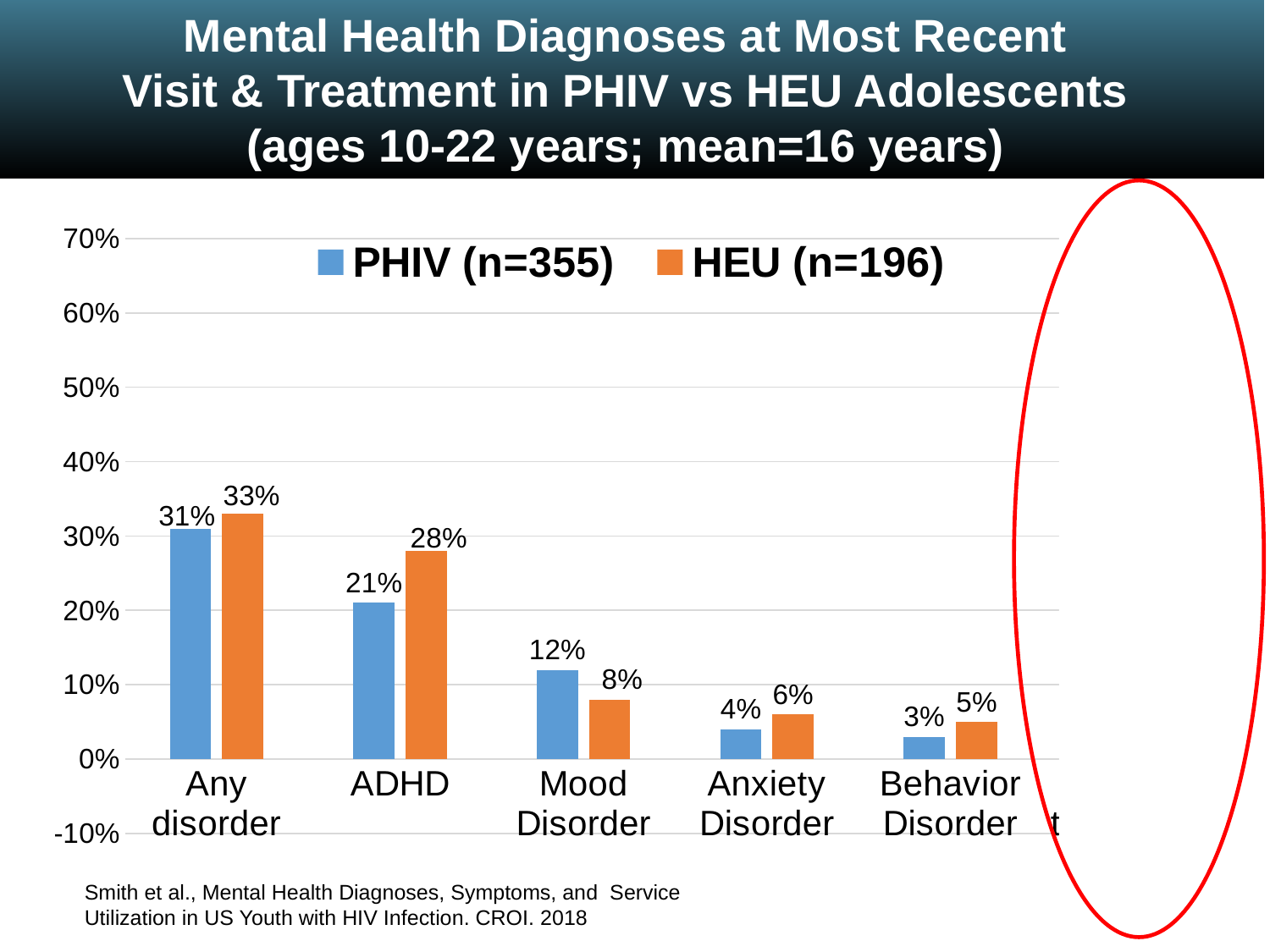
What is the HEU (n=196) value for Behavior Disorder? 5% What colour are the HEU (n=196) bars? orange What is the HEU (n=196) value for ADHD? 28% For Mood Disorder, which series has the larger value, PHIV (n=355) or HEU (n=196)? PHIV (n=355) What is the difference between the HEU (n=196) and PHIV (n=355) values for ADHD? 7% Which category has the lowest PHIV (n=355) value? Behavior Disorder How many series does the legend list? 2 Which category has the highest HEU (n=196) value? Any disorder What is the PHIV (n=355) value for Any disorder? 31% What kind of chart is shown on the slide? bar chart What is the PHIV (n=355) value for Mood Disorder? 12% Is the PHIV (n=355) value for Anxiety Disorder greater or less than 10%? less